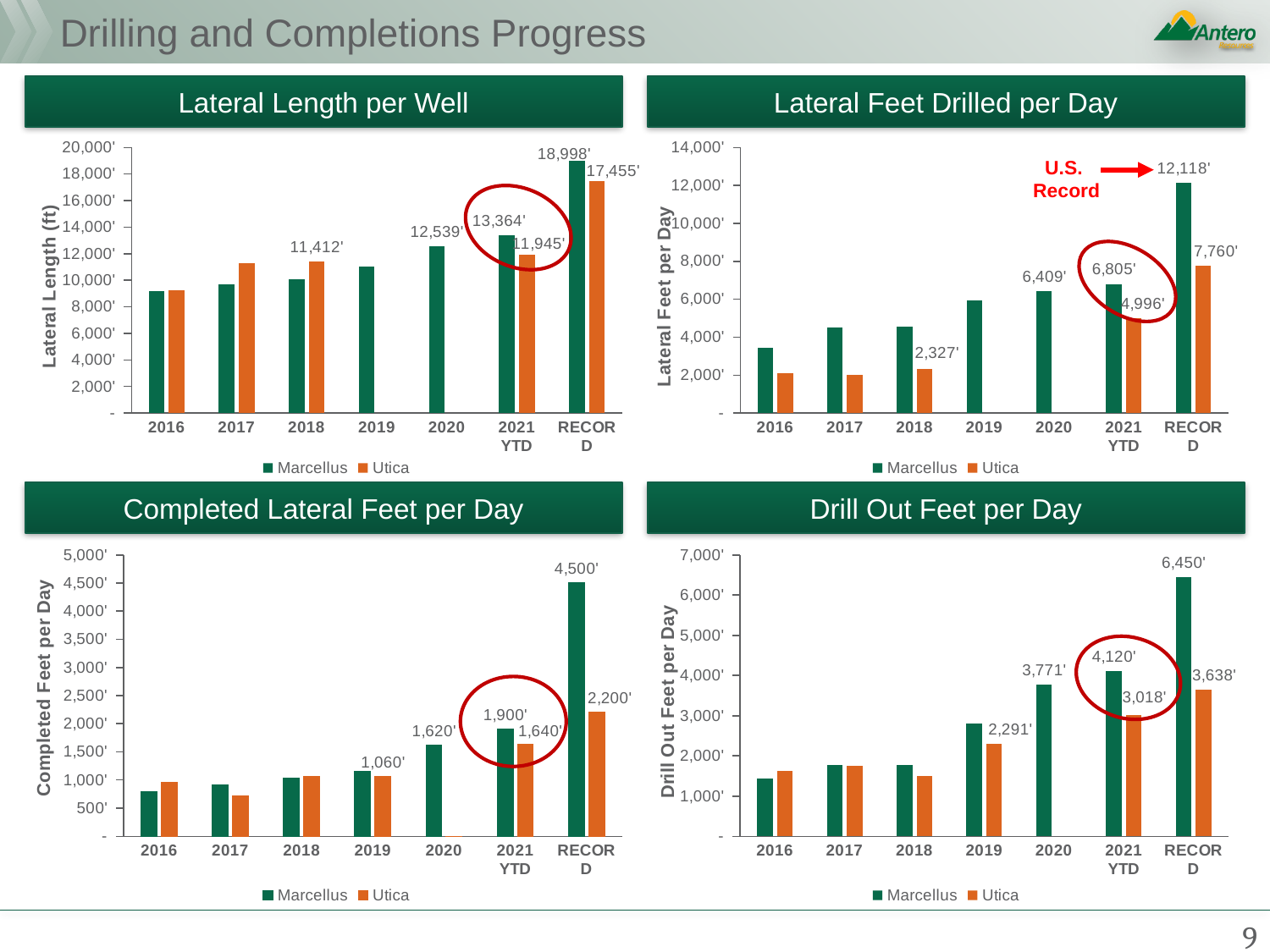
In the Lateral Length per Well chart, what is the Utica value for 2018? 11,412' In the Completed Lateral Feet per Day chart, what is the difference between the Marcellus and Utica values for 2021 YTD? 260' In the Completed Lateral Feet per Day chart, which category has the highest Marcellus value? RECORD In the Lateral Feet Drilled per Day chart, is the Marcellus value for 2019 greater or less than 4,000'? greater In the Drill Out Feet per Day chart, what is the Utica value for 2019? 2,291' In the Lateral Feet Drilled per Day chart, what is the Marcellus RECORD value labelled as the U.S. Record? 12,118' In the Drill Out Feet per Day chart, which is larger, the Marcellus value for 2021 YTD or the Utica RECORD value? Marcellus 2021 YTD In the Lateral Feet Drilled per Day chart, what is the Utica value for 2021 YTD? 4,996' In the Lateral Length per Well chart, what is the Marcellus value for 2021 YTD? 13,364' In the Lateral Length per Well chart, what is the difference between the Marcellus and Utica RECORD values? 1,543' What kind of chart is the Completed Lateral Feet per Day chart? Bar chart How many series does the legend of the Drill Out Feet per Day chart list? 2